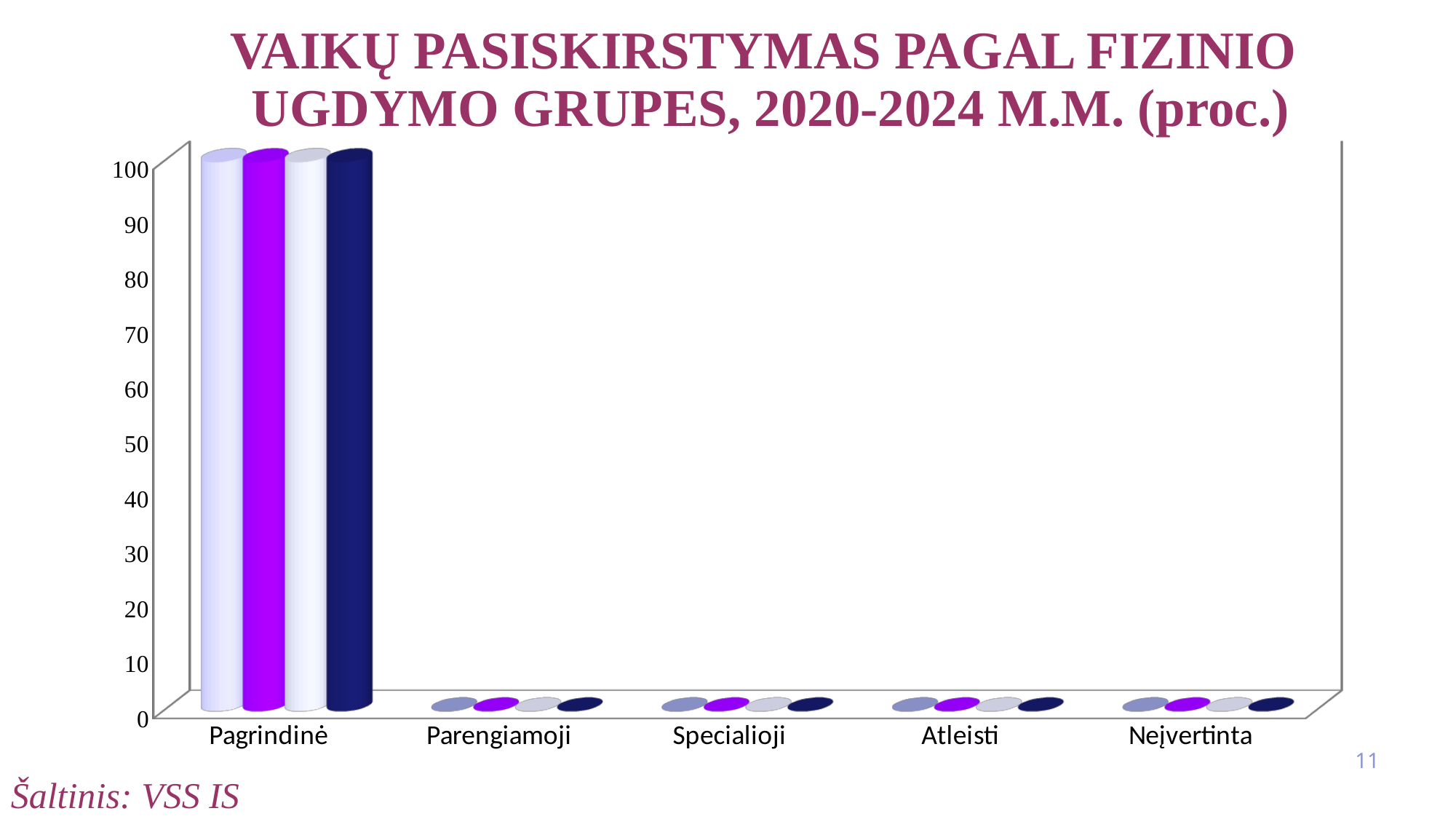
How many categories are shown on the x axis of the chart? 5 Are the values for Pagrindinė greater or less than 90? greater What is the title of the chart? VAIKŲ PASISKIRSTYMAS PAGAL FIZINIO UGDYMO GRUPES, 2020-2024 M.M. (proc.) Are the values for Neįvertinta greater or less than 10? less Are the values for Specialioji greater or less than 20? less What source is cited below the chart? VSS IS Which category has larger values, Pagrindinė or Atleisti? Pagrindinė What kind of chart is shown on the slide? bar chart Which category has the highest values in the chart? Pagrindinė Which category has larger values, Specialioji or Pagrindinė? Pagrindinė What is the highest value shown on the vertical axis of the chart? 100